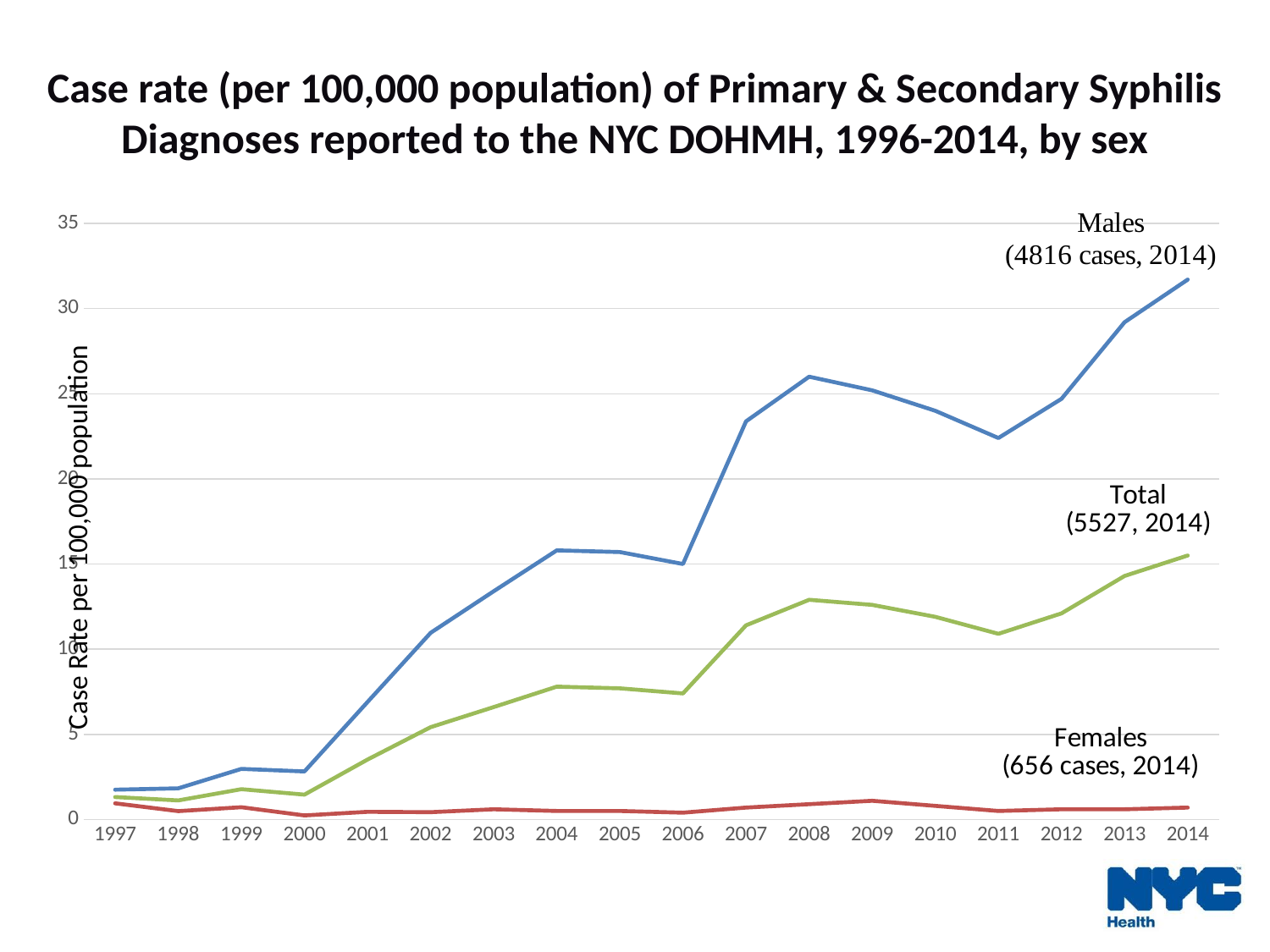
Is the case rate for Males in 2014 greater or less than 30? greater Is the case rate for Females in 2009 greater or less than 5? less How many series are plotted on the chart? 3 Is the case rate for Total in 2004 greater or less than 5? greater What is the first year shown on the x axis? 1997 How many years are shown along the x axis? 18 Which series has the highest case rate in 2014? Males Does the Males case rate rise or fall from 2011 to 2014? rise What kind of chart is shown on the slide? line chart Which series has the lowest case rate in 2014? Females How many cases are noted for Males in 2014 on the chart annotation? 4816 cases